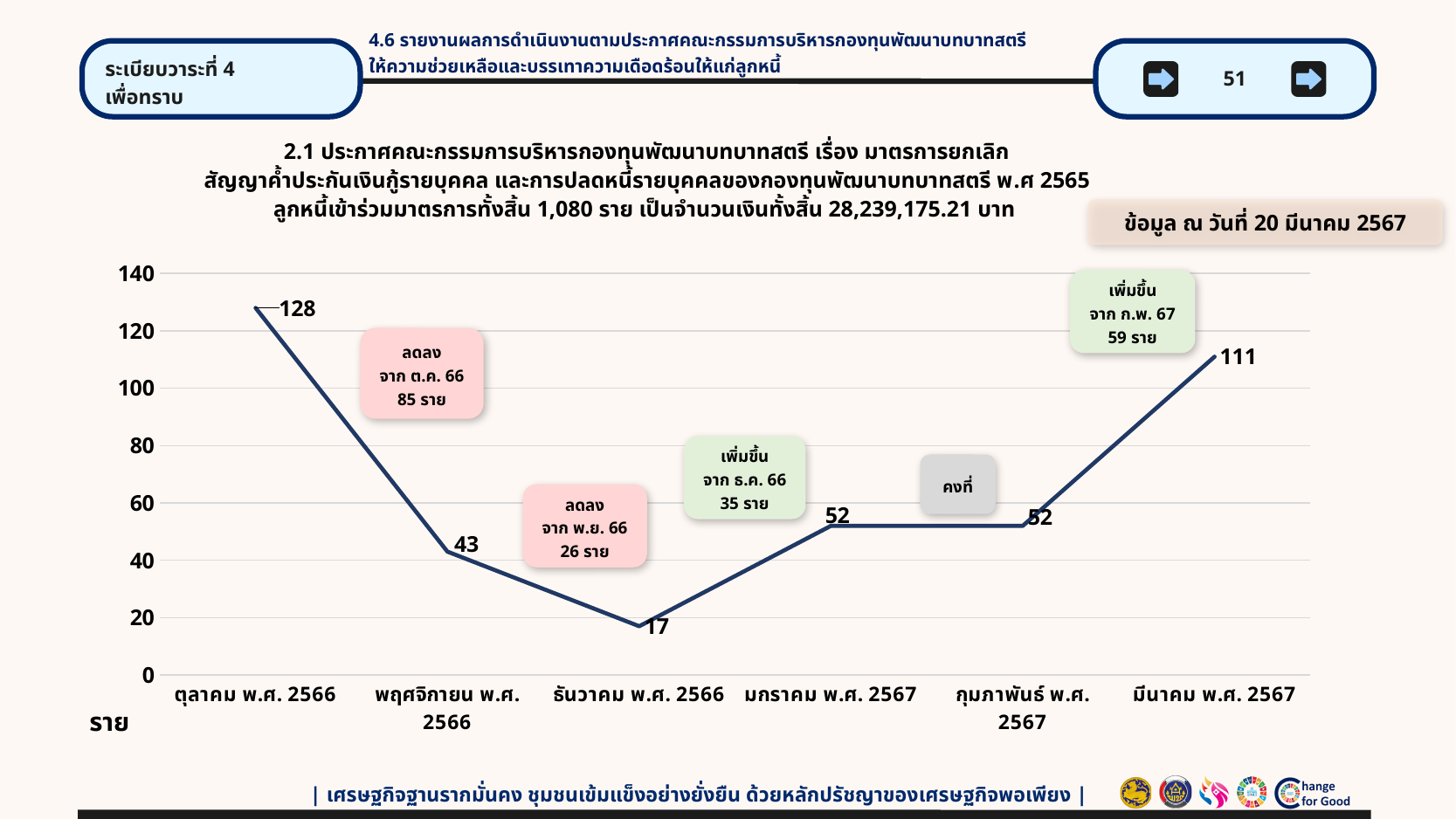
Which month has the highest value? ตุลาคม พ.ศ. 2566 What is the value for ตุลาคม พ.ศ. 2566 (October 2566)? 128 Does the value change between มกราคม พ.ศ. 2567 and กุมภาพันธ์ พ.ศ. 2567? No, it stays at 52 Which is larger, the value for ตุลาคม พ.ศ. 2566 or the value for มีนาคม พ.ศ. 2567? ตุลาคม พ.ศ. 2566 Which month has the lowest value? ธันวาคม พ.ศ. 2566 How many months (data points) are plotted on the chart? 6 What is the difference between the values for ตุลาคม พ.ศ. 2566 and พฤศจิกายน พ.ศ. 2566? 85 What type of chart is shown on the slide? Line chart What is the value for พฤศจิกายน พ.ศ. 2566 (November 2566)? 43 What is the value for มีนาคม พ.ศ. 2567 (March 2567)? 111 What is the difference between the values for มีนาคม พ.ศ. 2567 and กุมภาพันธ์ พ.ศ. 2567? 59 What is the value for ธันวาคม พ.ศ. 2566 (December 2566)? 17